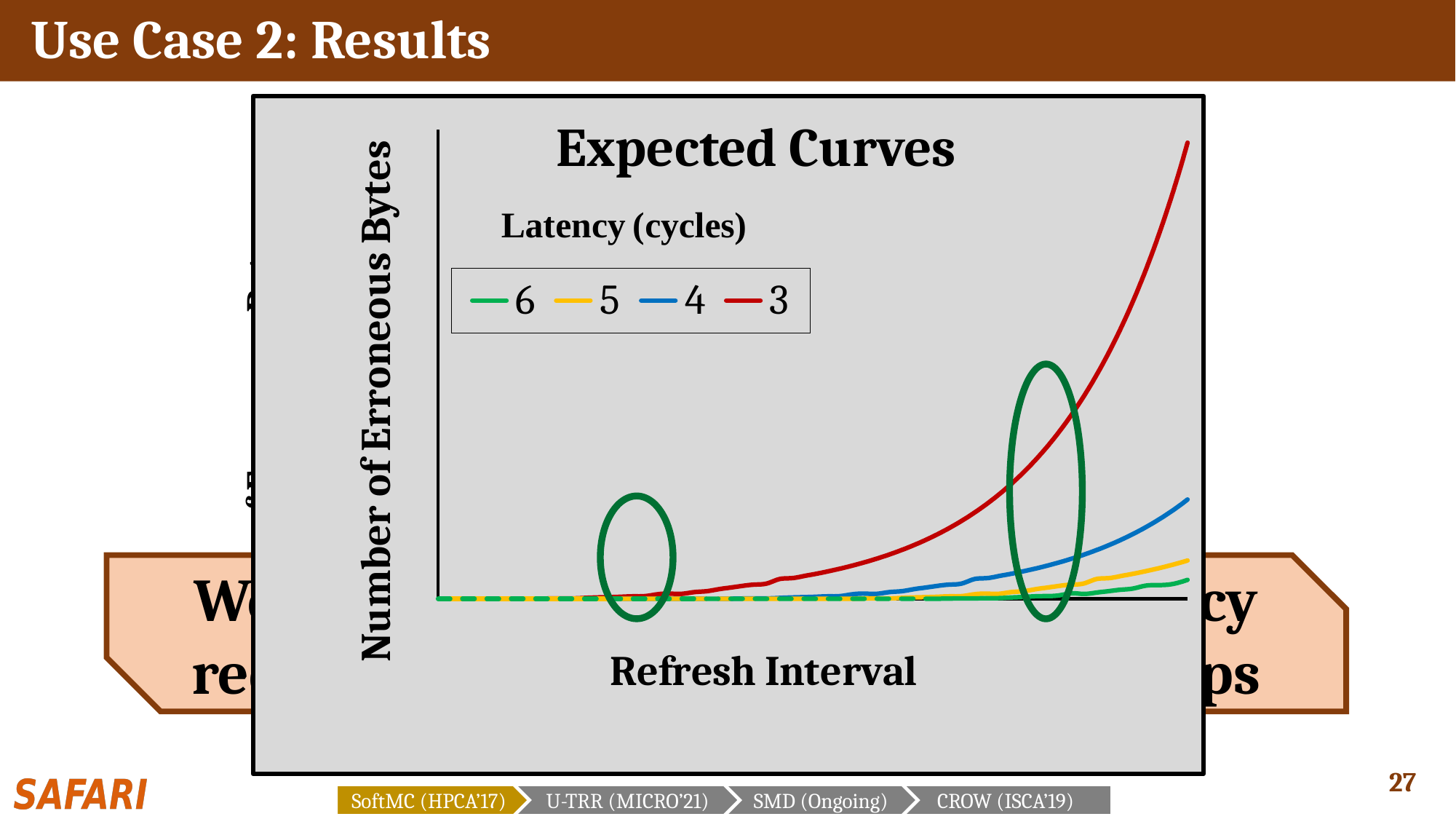
What is the label of the x axis? Refresh Interval Does the number of erroneous bytes for latency 4 rise or fall along the x axis? rise How many series does the chart's legend list? 4 Which latency series has the lowest number of erroneous bytes at the right end of the chart? 6 Does the number of erroneous bytes for latency 3 rise or fall as the refresh interval increases? rise What is the title of the chart? Expected Curves At the right end of the chart, which series is higher: latency 4 or latency 5? latency 4 What type of chart is shown on the slide? line chart Which latency series reaches the highest number of erroneous bytes at the right end of the chart? 3 At the right end of the chart, which series is higher: latency 5 or latency 6? latency 5